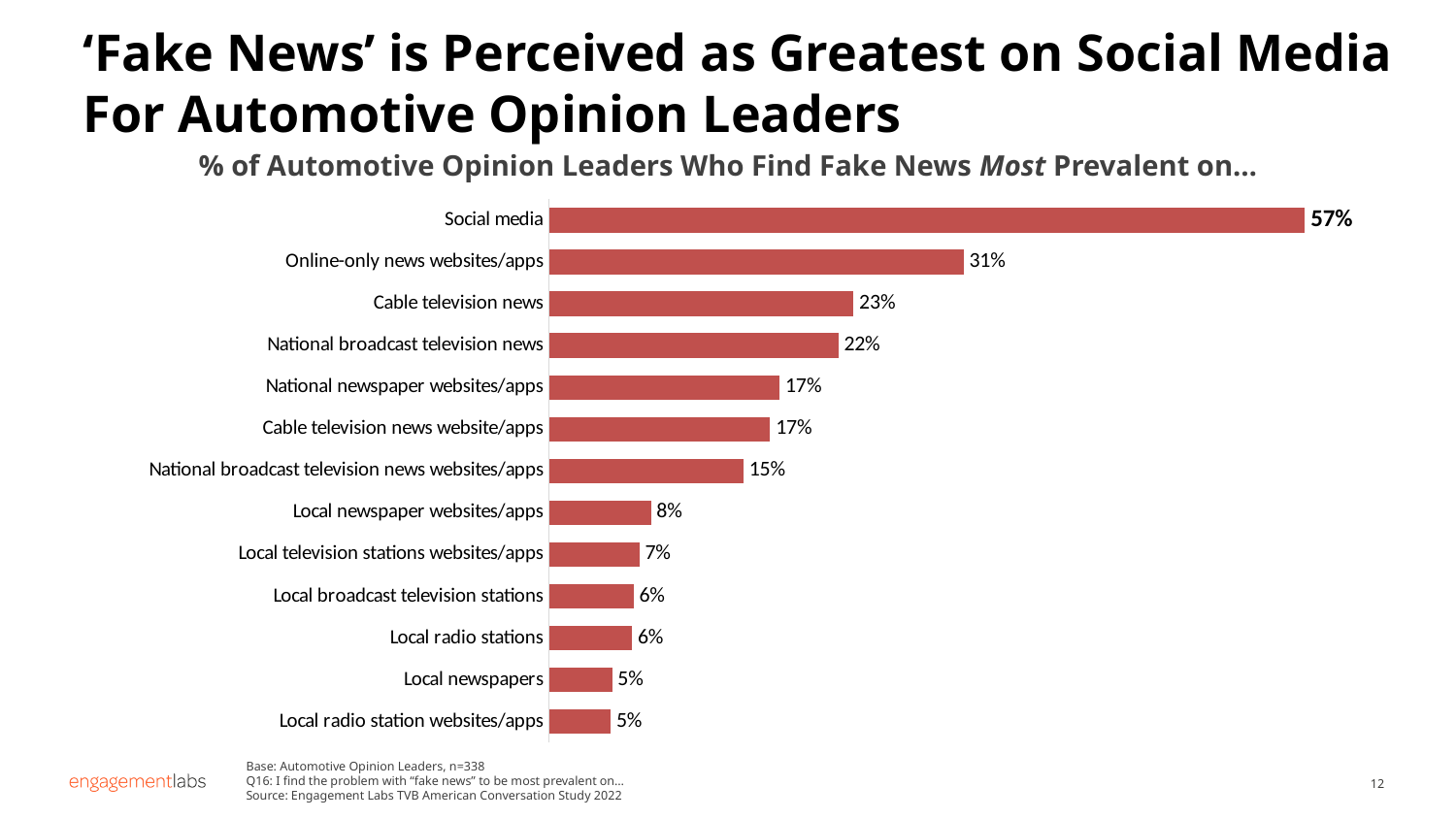
What kind of chart is shown on the slide? Bar chart What is the value for Local newspaper websites/apps? 8% How many categories are shown in the chart? 13 Which is larger, the value for Local newspaper websites/apps or the value for Local radio stations? Local newspaper websites/apps What is the difference between the values for Social media and Online-only news websites/apps? 26% What is the value for National broadcast television news websites/apps? 15% What is the value for Cable television news? 23% What is the difference between the values for Cable television news and National broadcast television news? 1% Which is larger, the value for Online-only news websites/apps or the value for Cable television news? Online-only news websites/apps Which category has the highest value? Social media What percentage of automotive opinion leaders find fake news most prevalent on social media? 57% What is the title of the chart? % of Automotive Opinion Leaders Who Find Fake News Most Prevalent on…